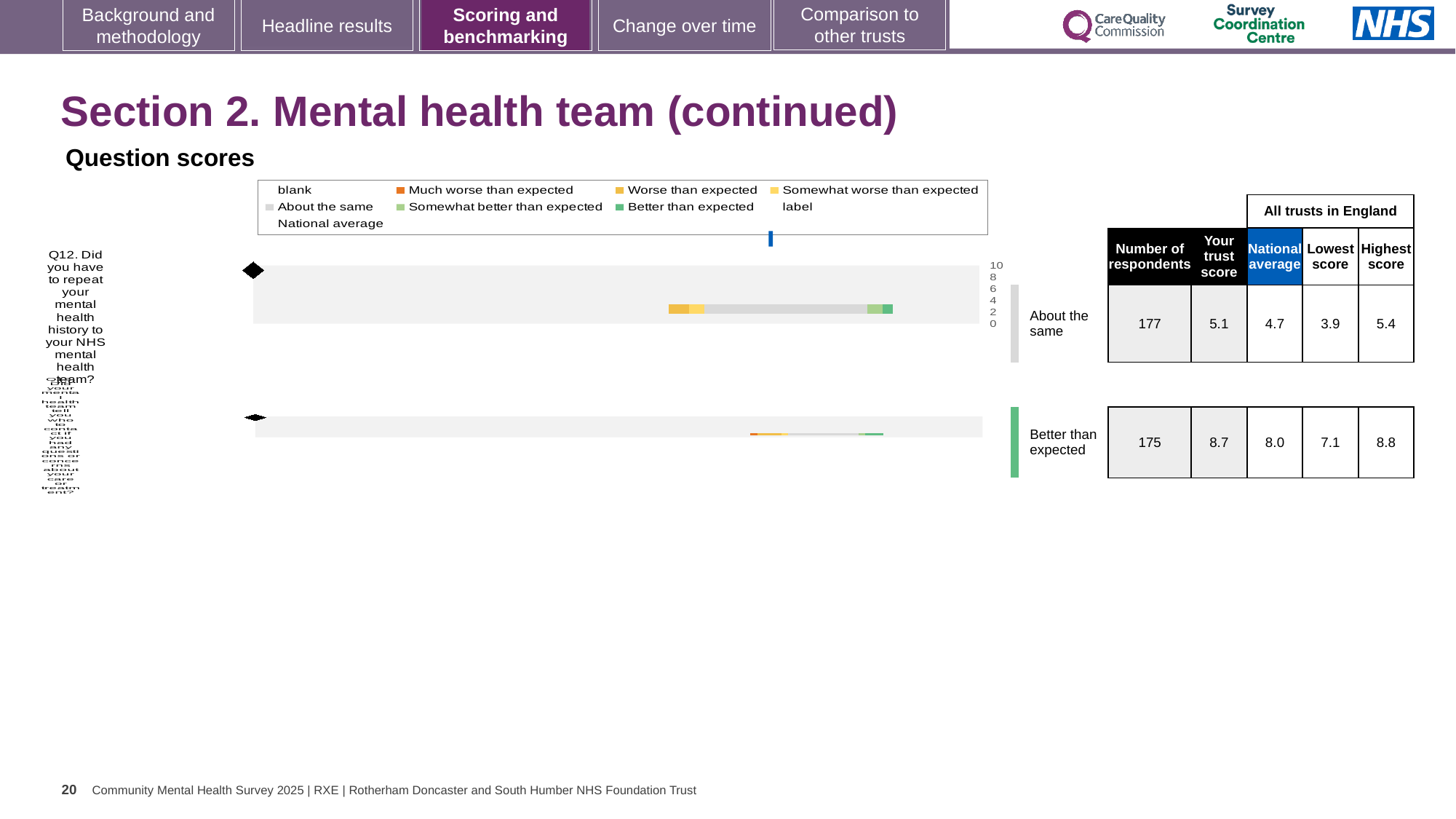
What is the highest value shown on the chart's axis? 10 What benchmark category is shown for Q12? About the same What benchmark category is shown for the second question row in the chart? Better than expected What kind of chart is shown on the slide? bar chart For Q12, what is the difference between the trust score and the national average? 0.4 In the table beside the chart, what is the trust score for Q12? 5.1 In the table beside the chart, what is the highest score across all trusts in England for Q12? 5.4 In the table beside the chart, what is the national average for Q12? 4.7 In the table beside the chart, what is the number of respondents for Q12? 177 For Q12, which is larger: the trust score or the national average? the trust score In the table beside the chart, what is the trust score for the second question row? 8.7 How many questions (rows) are plotted in the chart? 2